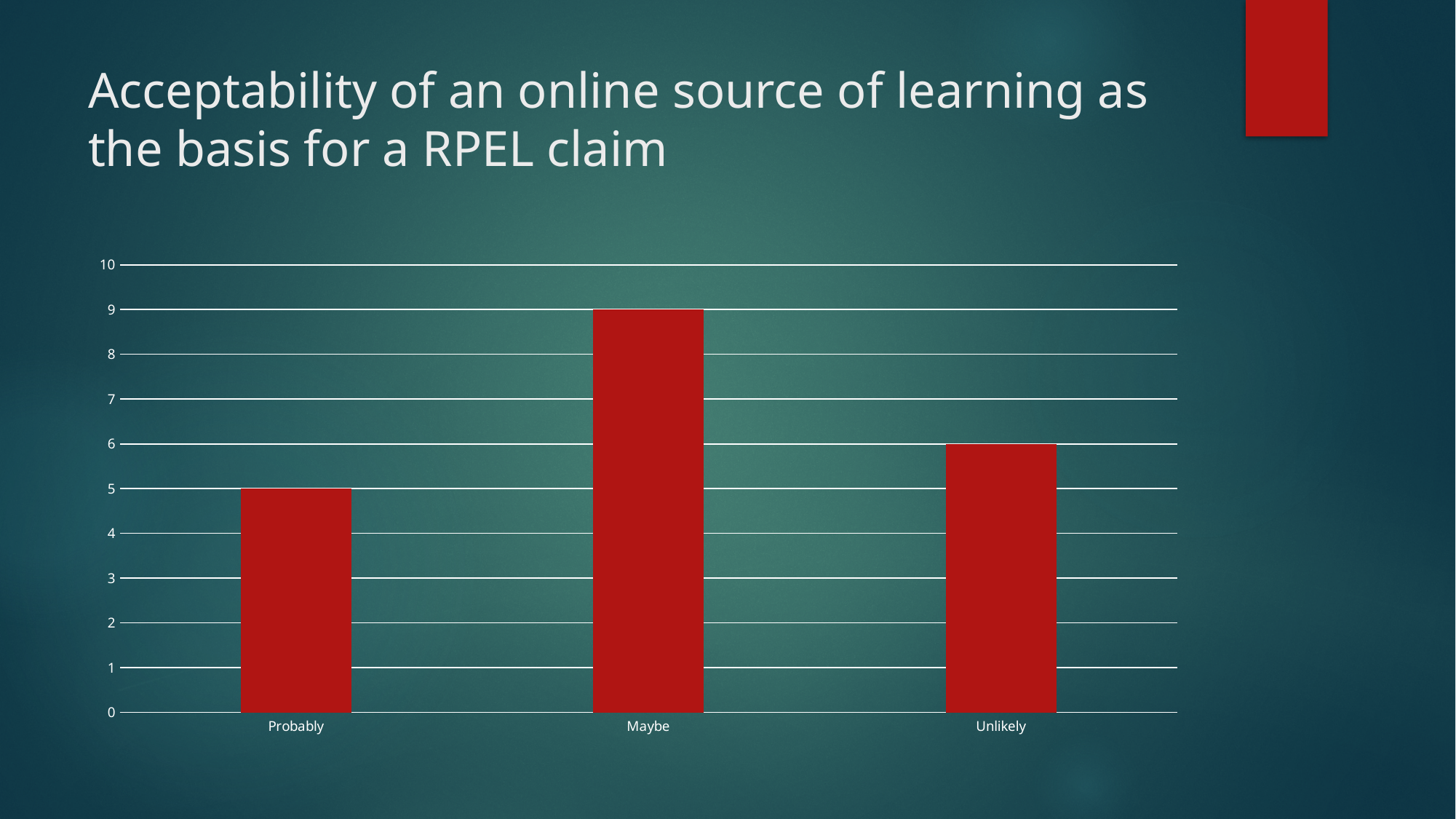
Which category has the highest value? Maybe Is the value for Maybe greater or less than 8? greater What is the difference between the values for Unlikely and Probably? 1 What is the title of the slide containing the chart? Acceptability of an online source of learning as the basis for a RPEL claim What is the value for Probably? 5 What is the value for Unlikely? 6 What is the value for Maybe? 9 What kind of chart is shown on the slide? bar chart What is the difference between the values for Maybe and Probably? 4 Which category has the lowest value? Probably How many categories are shown on the x axis? 3 Which is larger, the value for Maybe or the value for Unlikely? Maybe